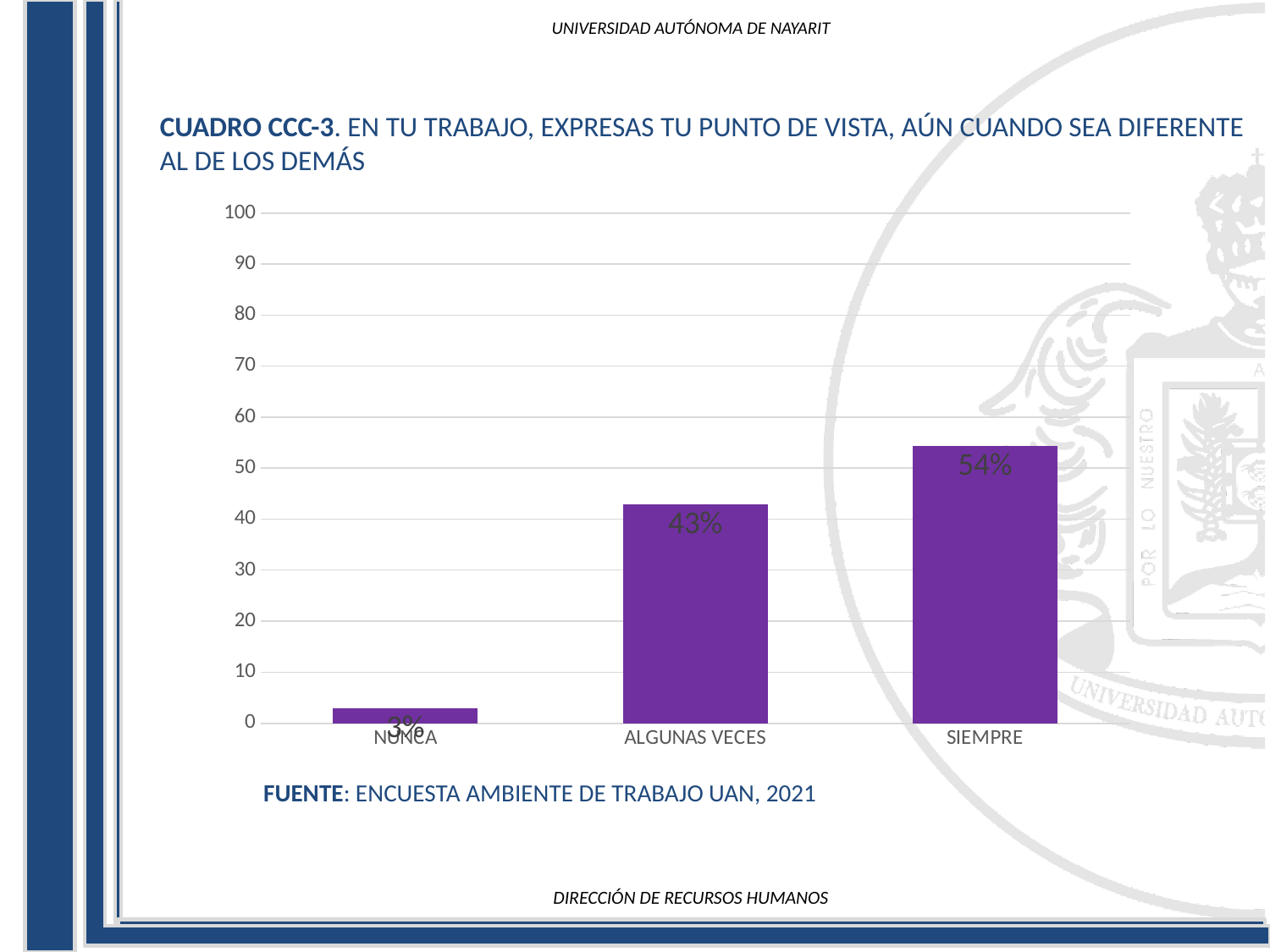
What is the value for NUNCA? 3% Which category has the lowest value? NUNCA What kind of chart is shown on the slide? bar chart How many categories are shown on the x axis? 3 What is the value for SIEMPRE? 54% What is the value for ALGUNAS VECES? 43% What is the difference between the values for ALGUNAS VECES and NUNCA? 40% What is the difference between the values for SIEMPRE and ALGUNAS VECES? 11% Do the values rise or fall from NUNCA to SIEMPRE along the x axis? rise Is the value for SIEMPRE greater or less than 50? greater Which is larger, the value for ALGUNAS VECES or the value for SIEMPRE? SIEMPRE Which category has the highest value? SIEMPRE